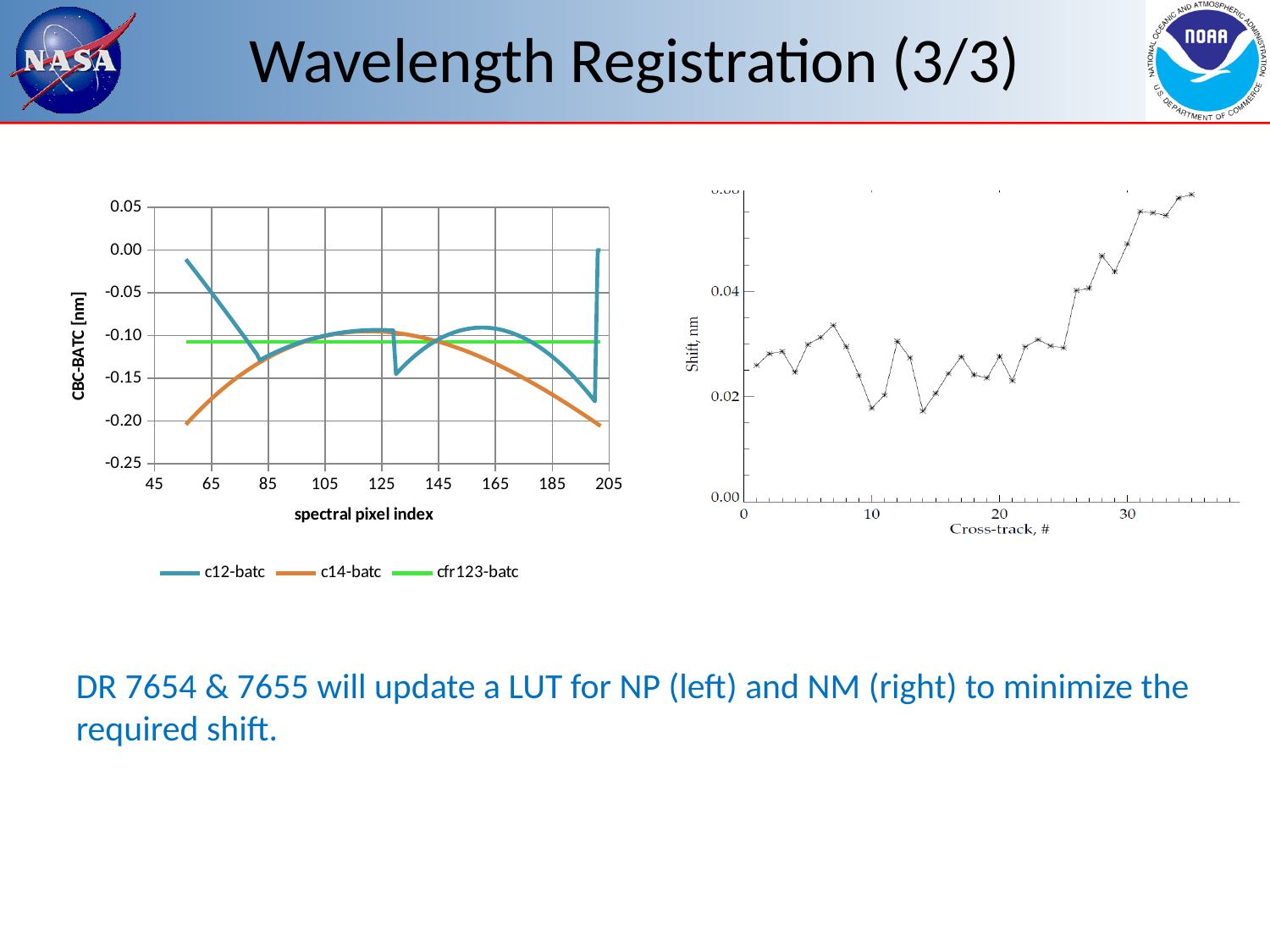
What type of chart is the right chart (Shift, nm vs Cross-track, #)? line chart What are the series names in the legend of the left chart? c12-batc, c14-batc, cfr123-batc On the left chart, is the cfr123-batc line greater or less than -0.05? less On the left chart, is the value of c14-batc at spectral pixel index 105 greater or less than -0.15? greater What is the x-axis title of the left chart? spectral pixel index On the left chart, is the value of c12-batc at spectral pixel index 65 greater or less than -0.10? greater How many series does the legend of the left chart list? 3 On the left chart, at spectral pixel index 65, which series has the larger value, c12-batc or c14-batc? c12-batc On the right chart, does the shift generally rise or fall as cross-track number increases from 25 to 35? rise On the left chart, does the cfr123-batc series rise, fall, or stay flat across the spectral pixel index? stays flat What type of chart is the left chart (CBC-BATC [nm] vs spectral pixel index)? line chart